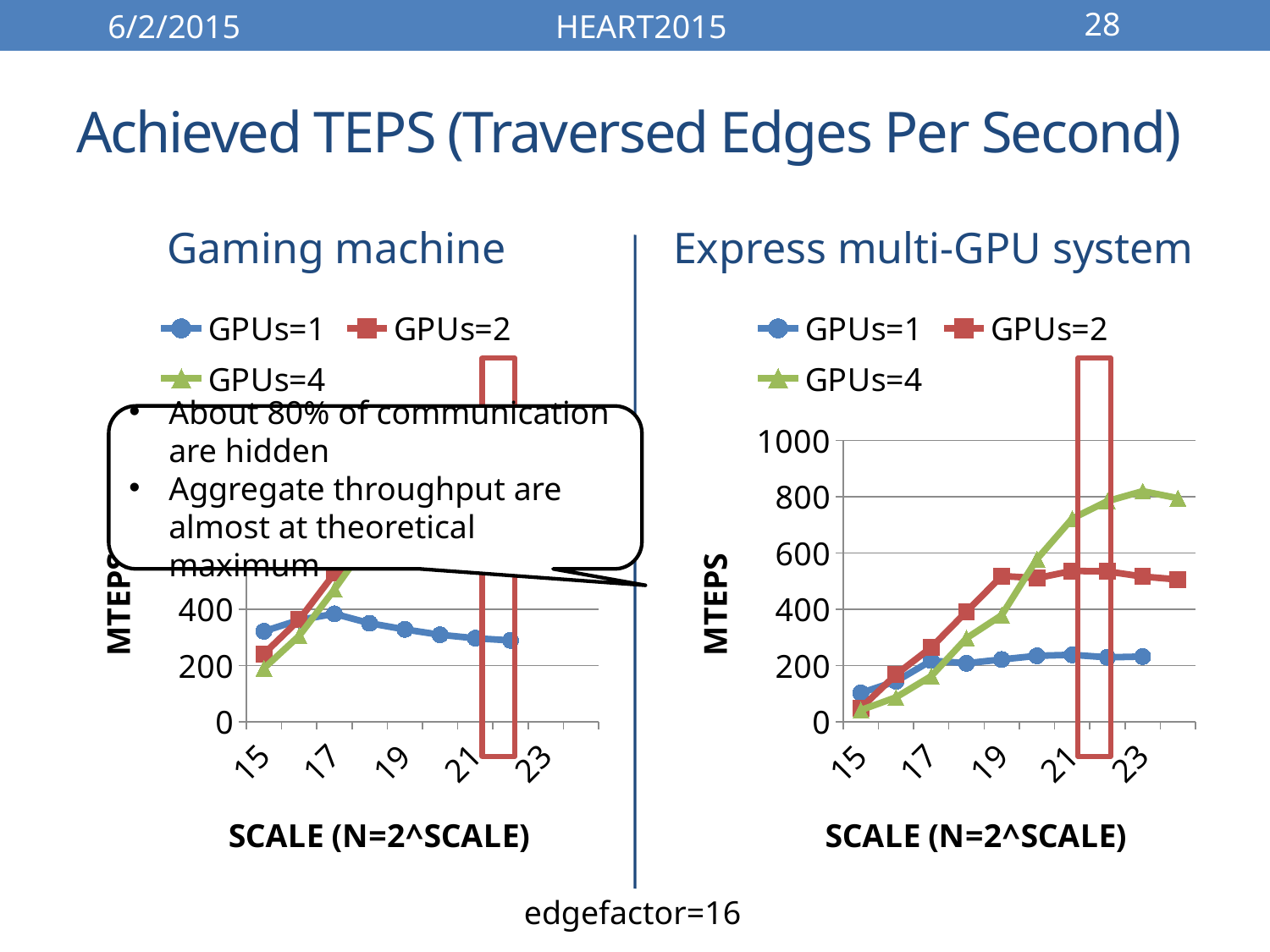
In the Gaming machine chart, is the value for GPUs=1 at scale 21 greater or less than 400? less In the Express multi-GPU system chart, is the value for GPUs=4 at scale 23 greater or less than 600? greater In the Express multi-GPU system chart, is the value for GPUs=1 at scale 23 greater or less than 400? less In the Express multi-GPU system chart, which series has the highest value at scale 23? GPUs=4 In the Express multi-GPU system chart, which is larger at scale 21: GPUs=2 or GPUs=4? GPUs=4 In the Express multi-GPU system chart, which series has the lowest value at scale 21? GPUs=1 What kind of chart is the Express multi-GPU system chart? line chart What is the y-axis title of the Express multi-GPU system chart? MTEPS How many series does the legend of the Gaming machine chart list? 3 In the Gaming machine chart, does the GPUs=1 series rise or fall from scale 17 to scale 22? fall How many series does the legend of the Express multi-GPU system chart list? 3